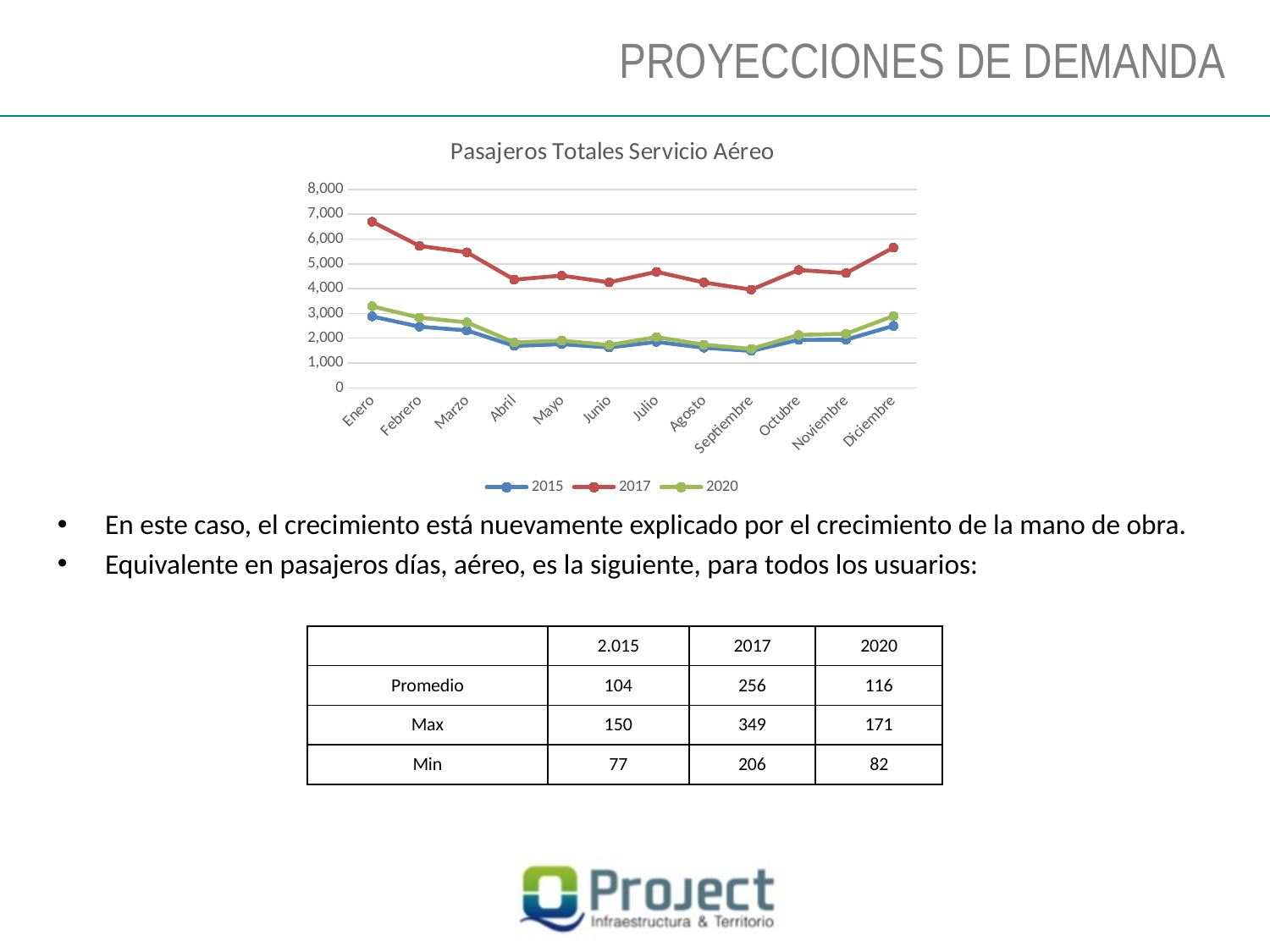
In which month does the 2017 series reach its highest value? Enero Is the value for 2020 in Enero greater or less than 3,000? greater Does the 2017 series rise or fall from Enero to Abril? fall Is the value for 2017 in Diciembre greater or less than 5,000? greater Is the value for 2017 in Enero greater or less than 6,000? greater What kind of chart is shown on the slide? line chart How many series does the chart legend list? 3 How many months are shown along the x axis of the chart? 12 Which series has the larger value in Enero, 2015 or 2017? 2017 In which month does the 2017 series reach its lowest value? Septiembre What is the title of the chart? Pasajeros Totales Servicio Aéreo